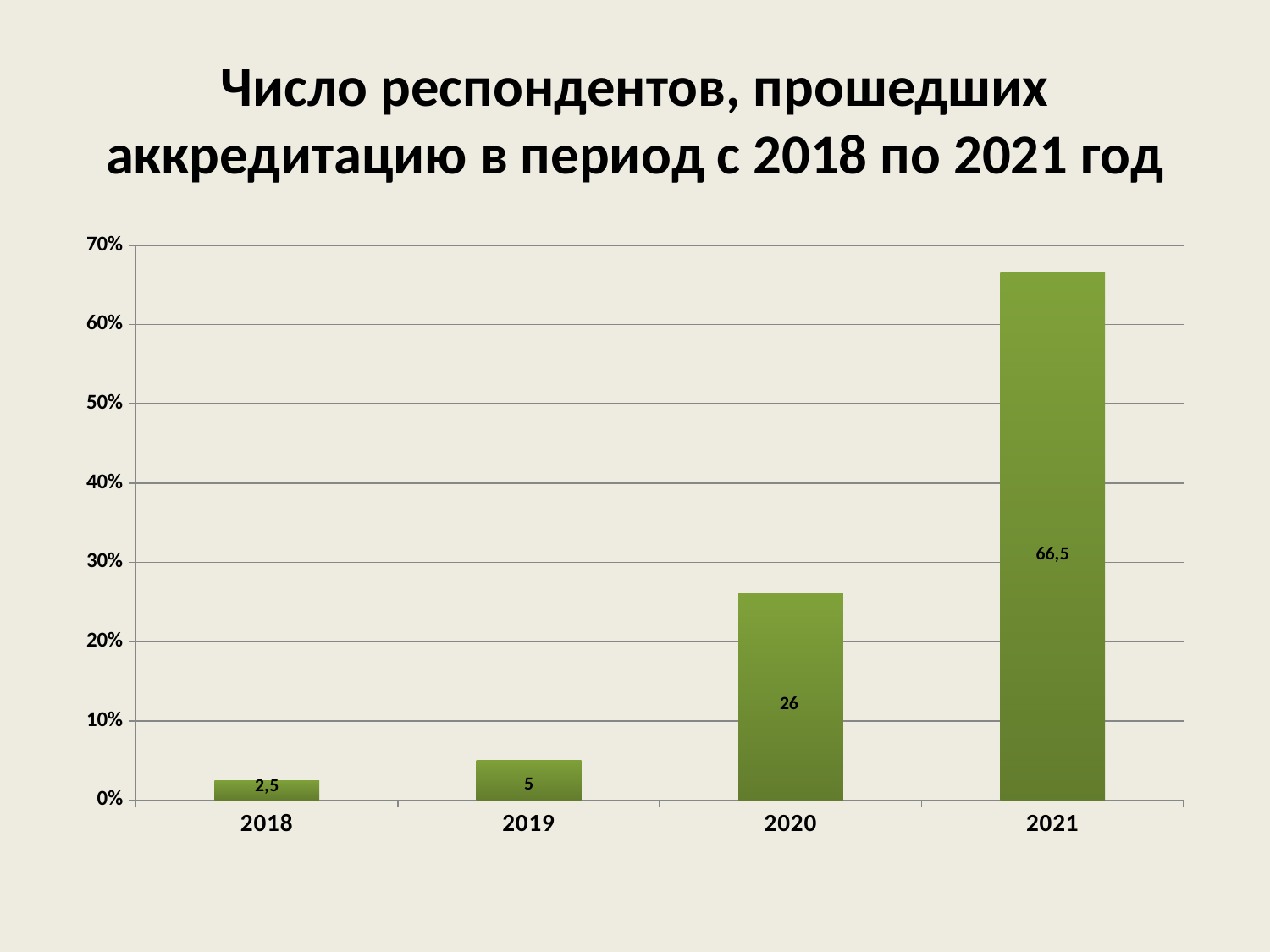
Is the value for 2021 greater or less than 60%? greater What is the value shown for 2019? 5 Do the values rise or fall from 2018 to 2021? rise Which year has the highest value? 2021 What is the difference between the values for 2020 and 2019? 21 Which year has the lowest value? 2018 What is the value shown for 2021? 66,5 What is the value shown for 2018? 2,5 What is the value shown for 2020? 26 What is the difference between the values for 2021 and 2020? 40,5 Which is larger, the value for 2019 or the value for 2020? 2020 How many years are shown on the x axis? 4